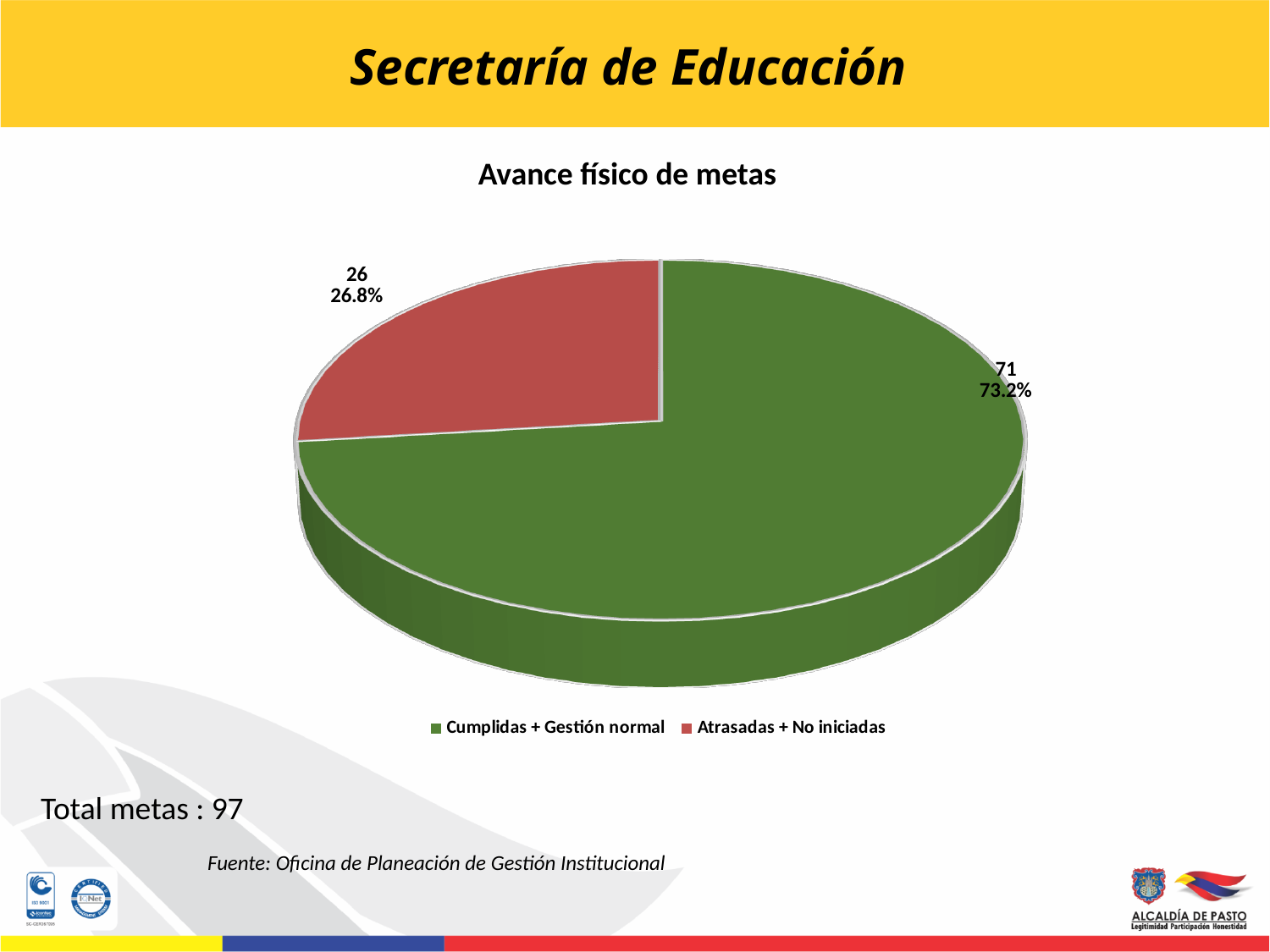
What share of the pie does Atrasadas + No iniciadas represent? 26.8% Which category has the smallest slice? Atrasadas + No iniciadas How many entries does the legend list? 2 What share of the pie does Cumplidas + Gestión normal represent? 73.2% What kind of chart is shown on the slide? pie chart Which category has the largest slice? Cumplidas + Gestión normal Which colour represents Atrasadas + No iniciadas in the chart? red What is the value for Cumplidas + Gestión normal? 71 What is the value for Atrasadas + No iniciadas? 26 How many slices does the pie chart have? 2 What is the title of the chart? Avance físico de metas What is the difference between the values for Cumplidas + Gestión normal and Atrasadas + No iniciadas? 45